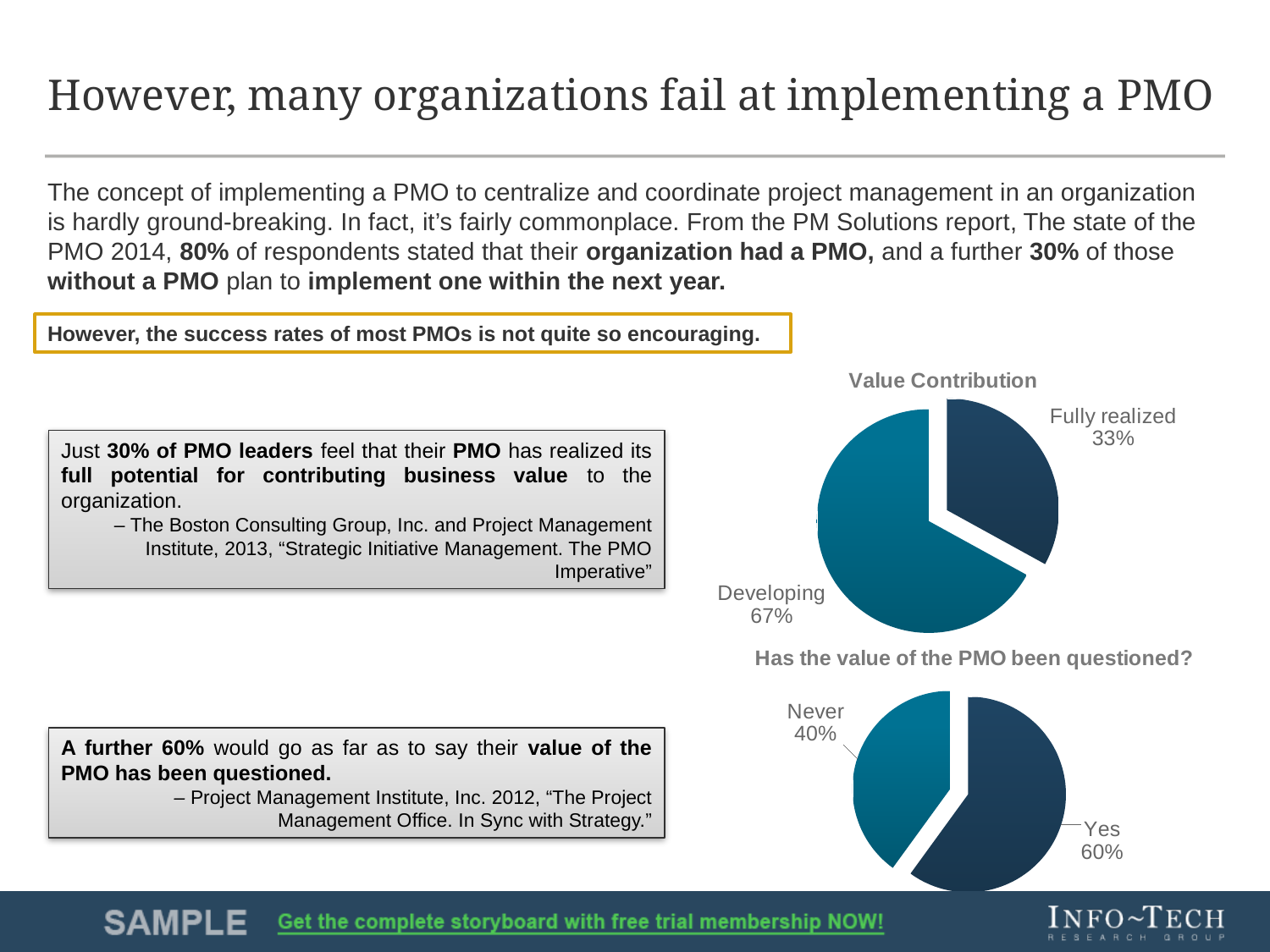
In the "Value Contribution" chart, what is the difference between the Developing and Fully realized percentages? 34% What kind of chart is the "Value Contribution" chart? Pie chart In the "Has the value of the PMO been questioned?" chart, what percentage answered "Never"? 40% In the "Has the value of the PMO been questioned?" chart, what is the difference between the Yes and Never percentages? 20% In the "Value Contribution" chart, what percentage is labelled "Fully realized"? 33% In the "Has the value of the PMO been questioned?" chart, which slice is the smallest? Never In the "Value Contribution" chart, what percentage is labelled "Developing"? 67% In the "Has the value of the PMO been questioned?" chart, is the "Yes" slice larger or smaller than the "Never" slice? Larger In the "Has the value of the PMO been questioned?" chart, what percentage answered "Yes"? 60% In the "Value Contribution" chart, which slice is the largest? Developing What is the title of the lower pie chart on the slide? Has the value of the PMO been questioned? How many slices does the "Value Contribution" chart have? 2